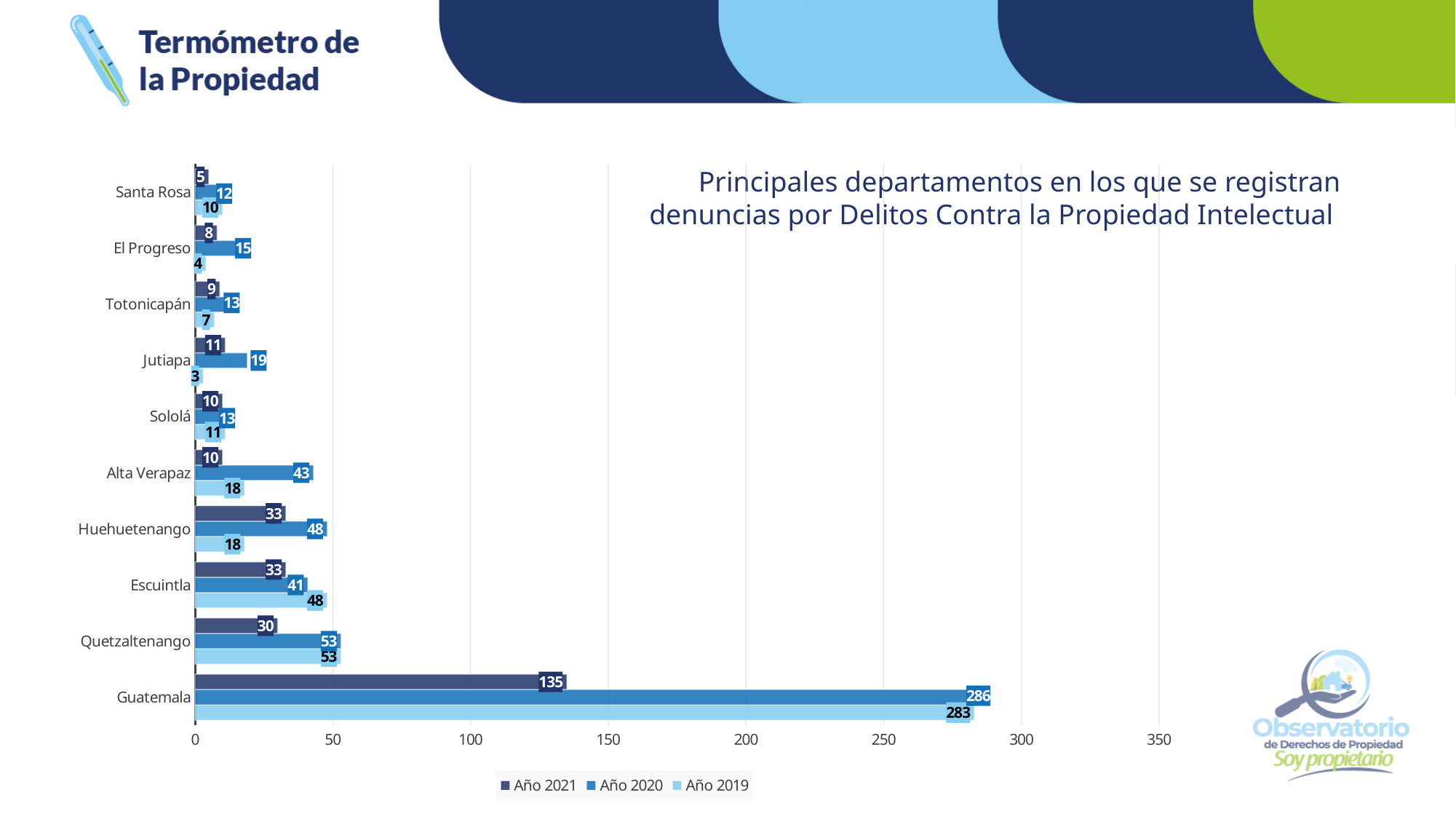
How many series does the legend list? 3 Which department has the highest value in Año 2021? Guatemala What is the value for Guatemala in Año 2020? 286 What is the value for Alta Verapaz in Año 2019? 18 What kind of chart is shown on the slide? Bar chart What is the value for Jutiapa in Año 2021? 11 How many departments are shown on the chart? 10 What is the difference between the Año 2020 and Año 2021 values for Guatemala? 151 Which department has the lowest value in Año 2019? Jutiapa Which is larger for Escuintla: the Año 2019 value or the Año 2020 value? Año 2019 Which series is shown in the lightest blue colour in the legend? Año 2019 Is the Año 2021 value for Guatemala greater or less than 150? less